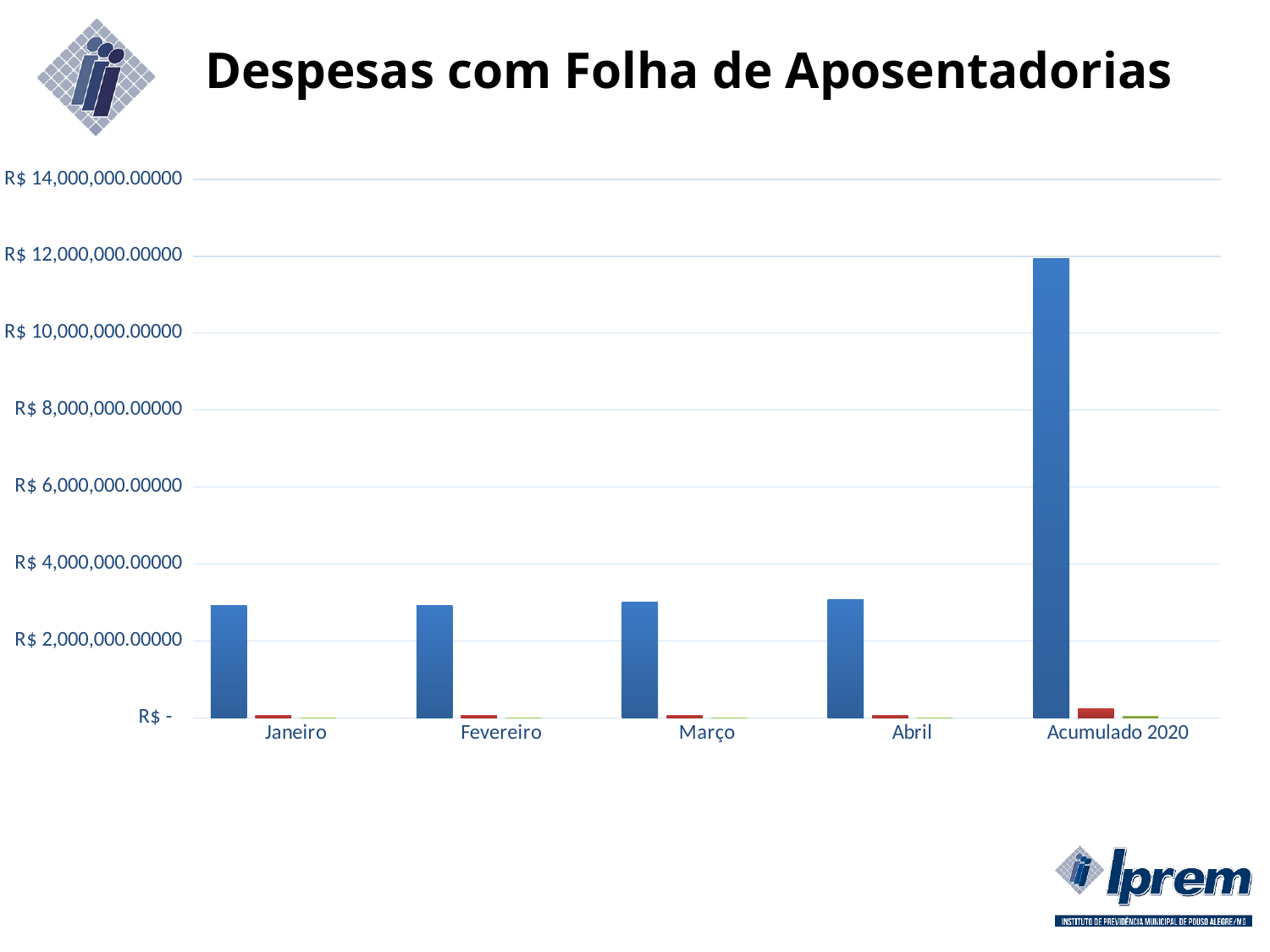
Which category has the tallest blue bar? Acumulado 2020 What is the highest value labelled on the vertical axis? R$ 14,000,000.00000 Is the blue bar for Acumulado 2020 greater or less than R$ 10,000,000.00000? greater Is the red bar for Acumulado 2020 greater or less than R$ 2,000,000.00000? less How many bars are plotted for each category on the x axis? 3 Which has the larger blue bar, Janeiro or Acumulado 2020? Acumulado 2020 How many categories are shown on the x axis of the chart? 5 Is the blue bar for Janeiro greater or less than R$ 4,000,000.00000? less What kind of chart is shown on the slide? bar chart What is the title of the chart? Despesas com Folha de Aposentadorias Within the Março category, which coloured bar is the tallest? blue